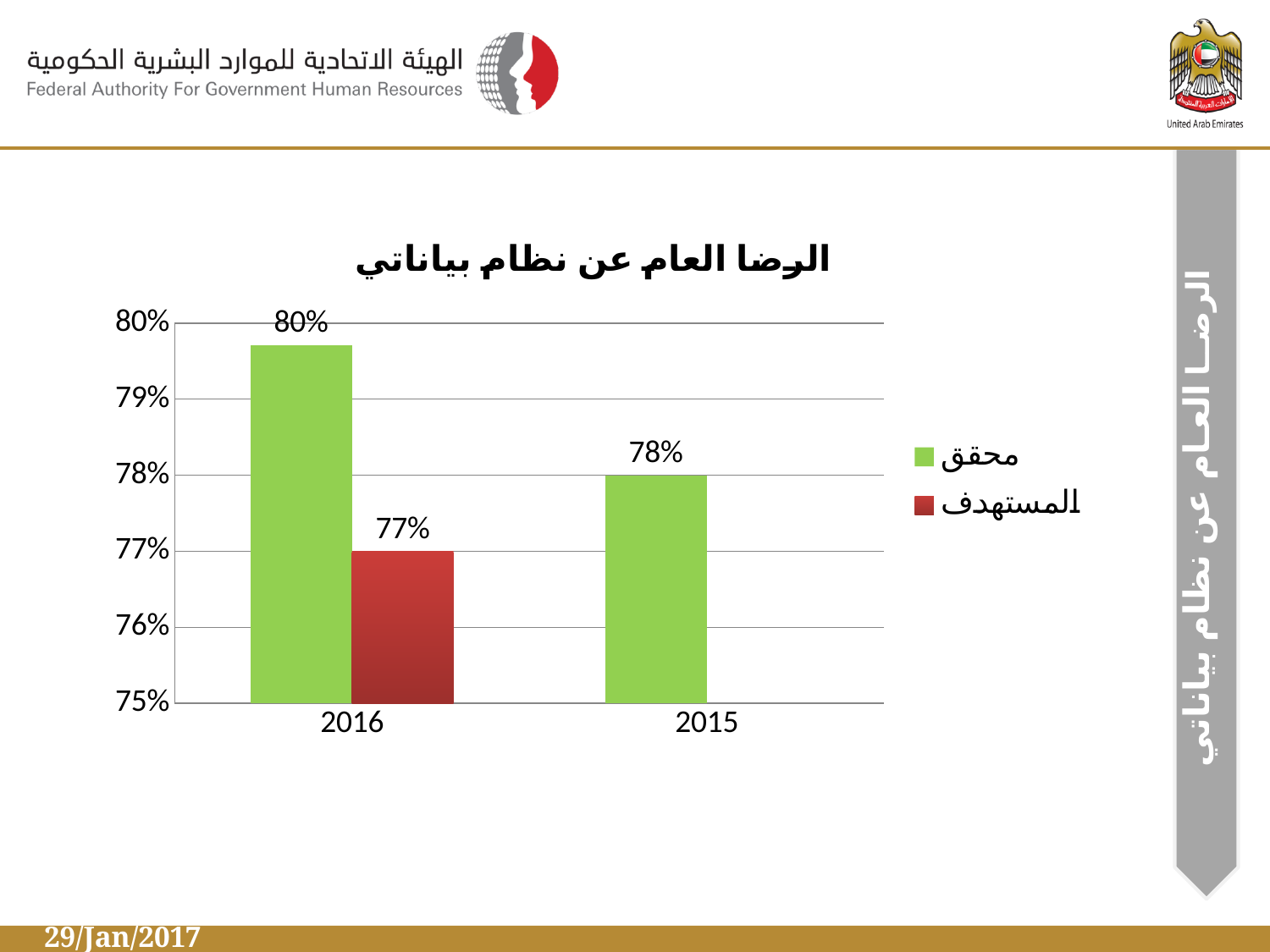
What is the value of the محقق (achieved) bar for 2015? 78% Which bar on the chart has the lowest value? المستهدف (target) for 2016, 77% What is the difference between the محقق (achieved) and المستهدف (target) values for 2016? 3% Is the محقق (achieved) value for 2015 greater or less than 79%? less How many series does the legend list? 2 What is the difference between the محقق (achieved) values for 2016 and 2015? 2% What is the value of the محقق (achieved) bar for 2016? 80% What kind of chart is shown on the slide? bar chart Which year has the higher محقق (achieved) value, 2016 or 2015? 2016 How many years (categories) are shown on the x axis? 2 What colour represents the المستهدف (target) series in the legend? red What is the value of the المستهدف (target) bar for 2016? 77%